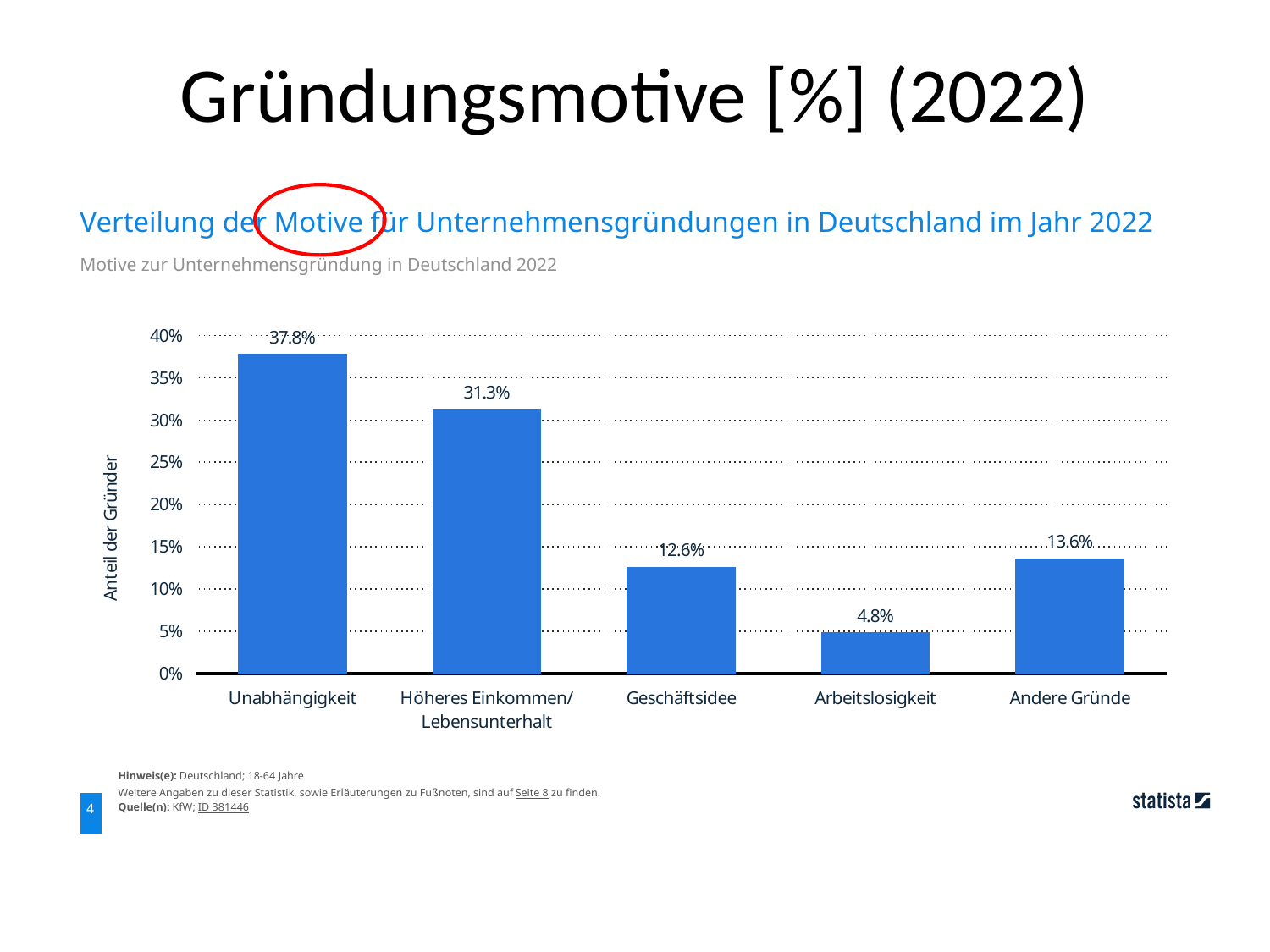
Which category has the lowest value? Arbeitslosigkeit What is the difference between the values for Unabhängigkeit and Höheres Einkommen/Lebensunterhalt? 6.5% What is the value for Geschäftsidee? 12.6% What kind of chart is shown on the slide? Bar chart Which category has the highest value? Unabhängigkeit What is the value for Andere Gründe? 13.6% What is the value for Unabhängigkeit? 37.8% What is the label of the y axis? Anteil der Gründer Which is larger, the value for Geschäftsidee or the value for Andere Gründe? Andere Gründe What is the value for Arbeitslosigkeit? 4.8% How many categories are shown on the x axis? 5 What is the value for Höheres Einkommen/Lebensunterhalt? 31.3%